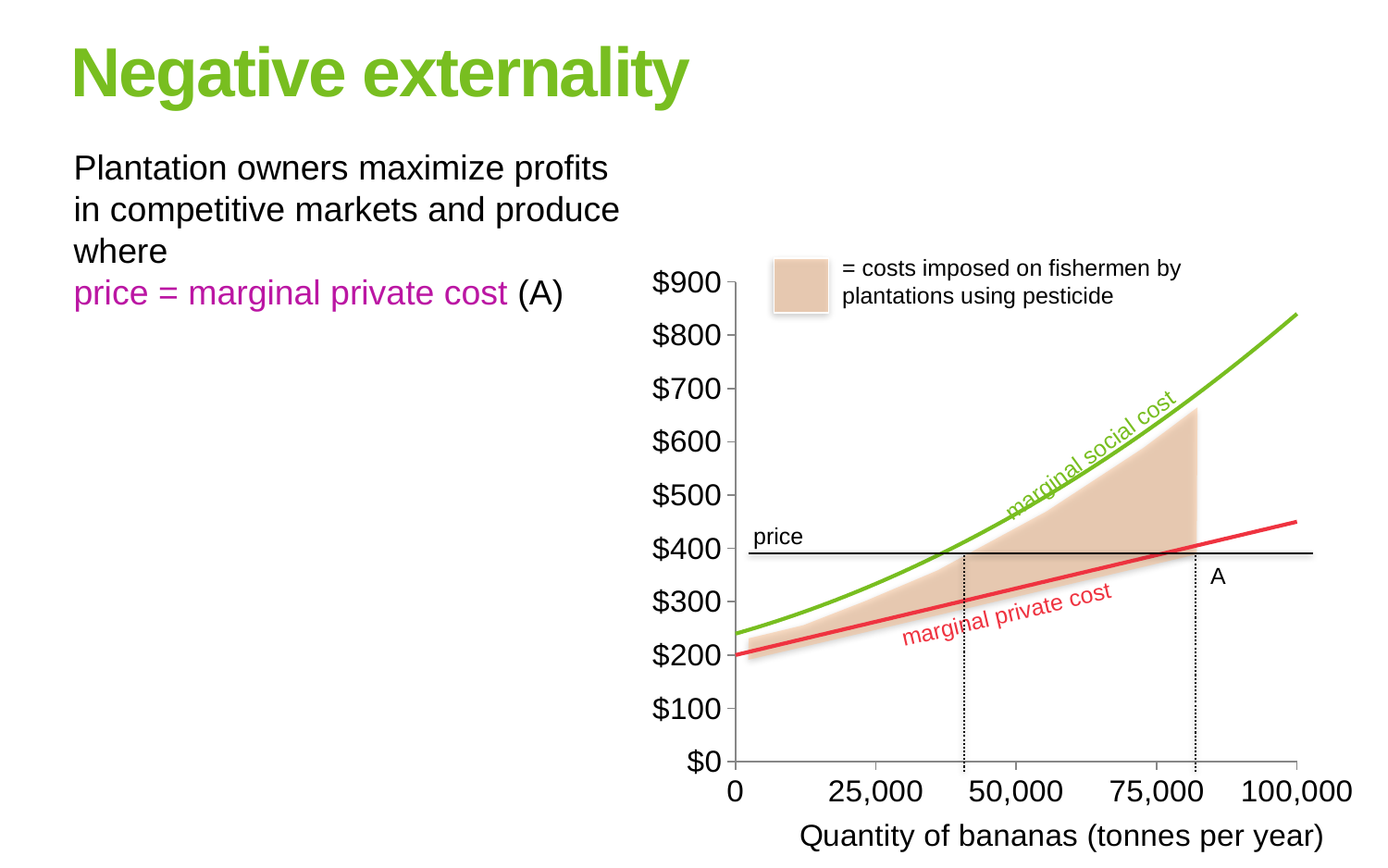
Is the marginal social cost at a quantity of 100,000 greater or less than $800? greater At a quantity of 100,000, which curve is higher: marginal social cost or marginal private cost? marginal social cost What is the highest value shown on the vertical axis? $900 Is the marginal private cost at a quantity of 100,000 greater or less than $400? greater Is the marginal social cost at a quantity of 0 greater or less than $300? less According to the legend, what does the shaded area represent? costs imposed on fishermen by plantations using pesticide Does the marginal social cost curve rise or fall as quantity increases? rise What is the label of the horizontal axis? Quantity of bananas (tonnes per year) What kind of chart is shown on the slide? line chart